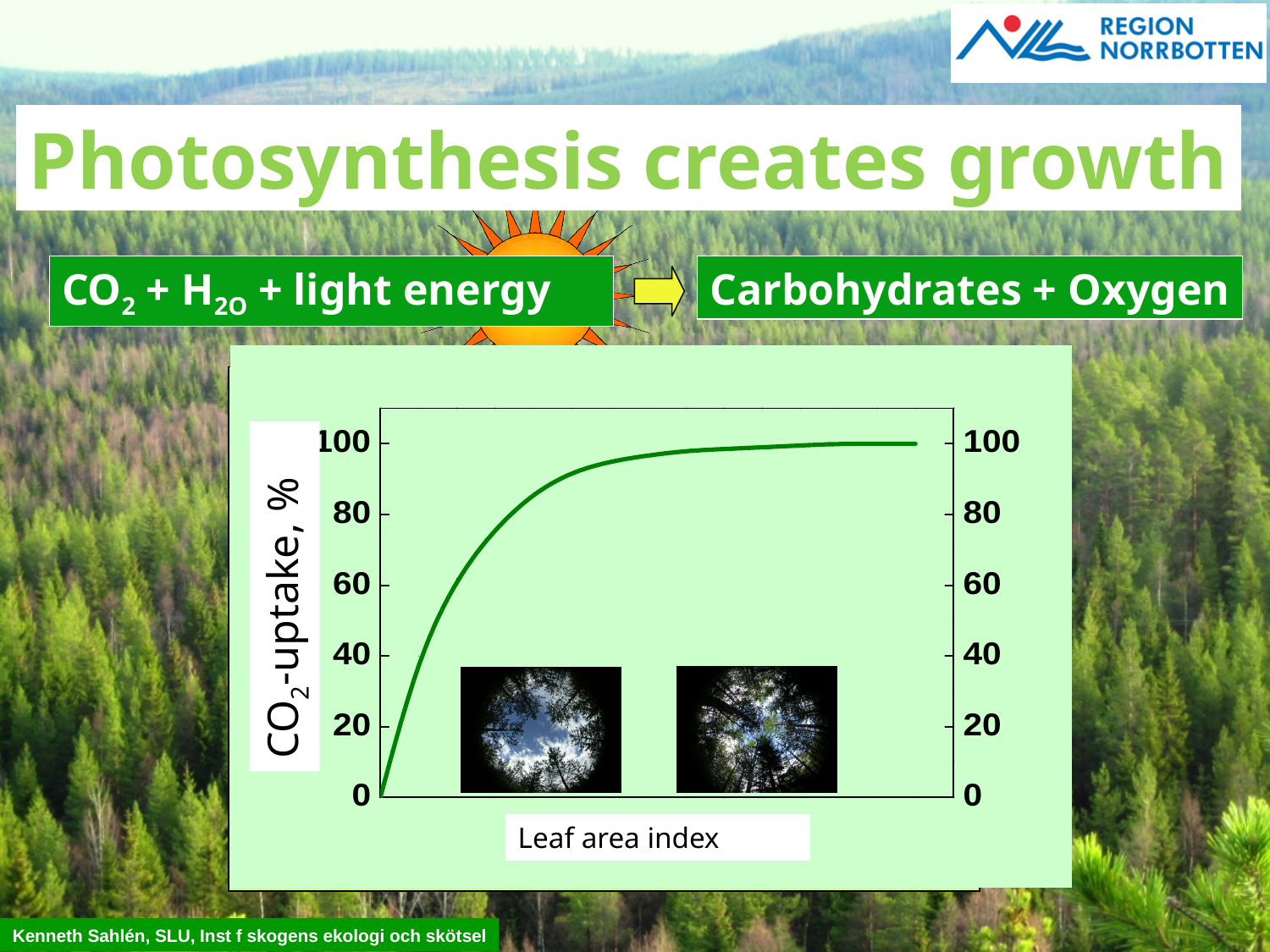
Is the CO2-uptake at the left end of the curve greater or less than 20? less How many lines (series) are plotted on the chart? 1 What kind of chart is shown on the slide? line chart What is the highest tick value shown on the y axis of the chart? 100 Does the CO2-uptake rise or fall as the leaf area index increases along the x axis? rise What is the label of the x axis of the chart? Leaf area index What is the lowest tick value shown on the y axis of the chart? 0 Is the CO2-uptake at the right end of the curve greater or less than 80? greater What is the label of the y axis of the chart? CO2-uptake, % Does the curve rise more steeply at low leaf area index or at high leaf area index? low leaf area index